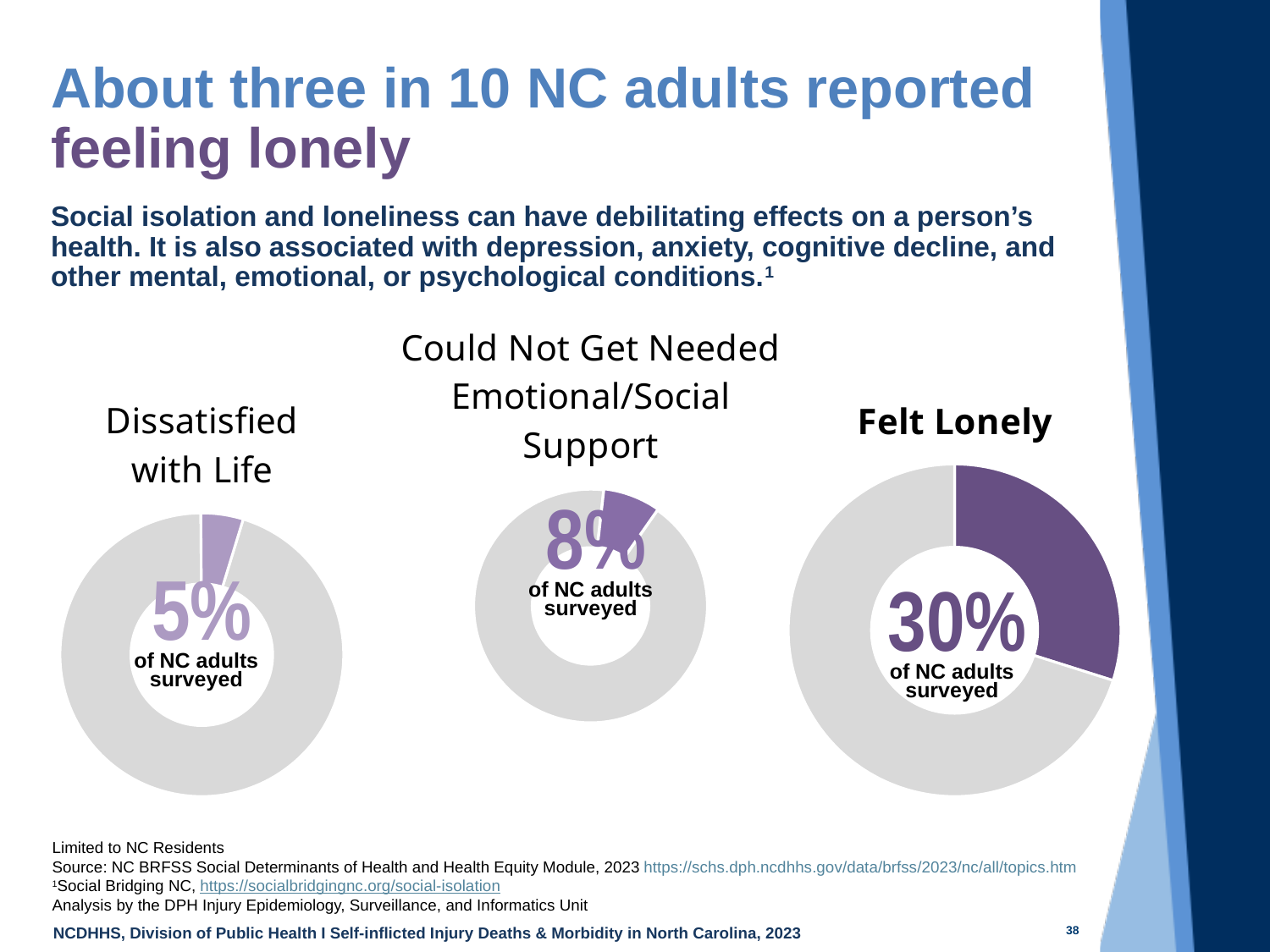
What is the difference in percentage points between the 'Felt Lonely' chart and the 'Dissatisfied with Life' chart? 25 In the 'Dissatisfied with Life' chart, what percentage of NC adults surveyed is shown? 5% How many donut charts are shown on the slide? 3 What is the difference in percentage points between the 'Could Not Get Needed Emotional/Social Support' chart and the 'Dissatisfied with Life' chart? 3 What is the title of the rightmost chart on the slide? Felt Lonely Across the three charts on the slide, which indicator has the lowest percentage? Dissatisfied with Life In the 'Felt Lonely' chart, what percentage of NC adults surveyed is shown? 30% Which is larger: the percentage in the 'Felt Lonely' chart or the percentage in the 'Could Not Get Needed Emotional/Social Support' chart? Felt Lonely Across the three charts on the slide, which indicator has the highest percentage? Felt Lonely In the 'Could Not Get Needed Emotional/Social Support' chart, what percentage of NC adults surveyed is shown? 8% What type of chart is used to show the 'Felt Lonely' percentage? Donut chart In the 'Felt Lonely' chart, what share of the ring is shaded in the dark purple colour? 30%